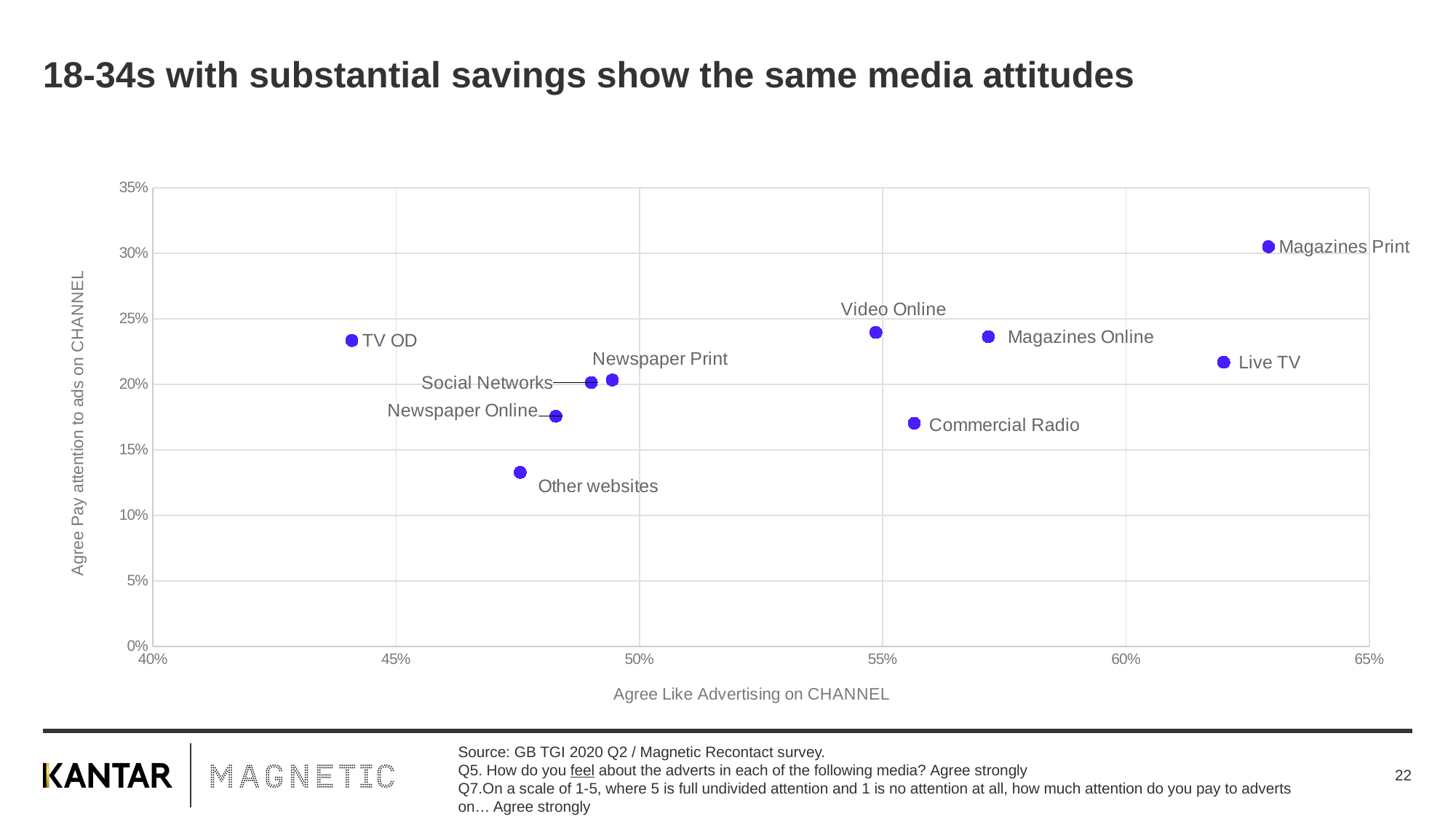
Is the 'Agree Pay attention to ads' value for Magazines Print greater or less than 25%? greater Which channel has the highest value for 'Agree Pay attention to ads on CHANNEL'? Magazines Print Which channel has the lowest value for 'Agree Like Advertising on CHANNEL'? TV OD What is the title of the horizontal axis? Agree Like Advertising on CHANNEL Is the 'Agree Like Advertising' value for Live TV greater or less than 60%? greater Is the 'Agree Pay attention to ads' value for Other websites greater or less than 15%? less How many media channels are plotted on the chart? 10 Which channel has the highest value for 'Agree Like Advertising on CHANNEL'? Magazines Print What kind of chart is shown on the slide? Scatter chart Which has a higher 'Agree Pay attention to ads' value, Live TV or Commercial Radio? Live TV Which channel has the lowest value for 'Agree Pay attention to ads on CHANNEL'? Other websites